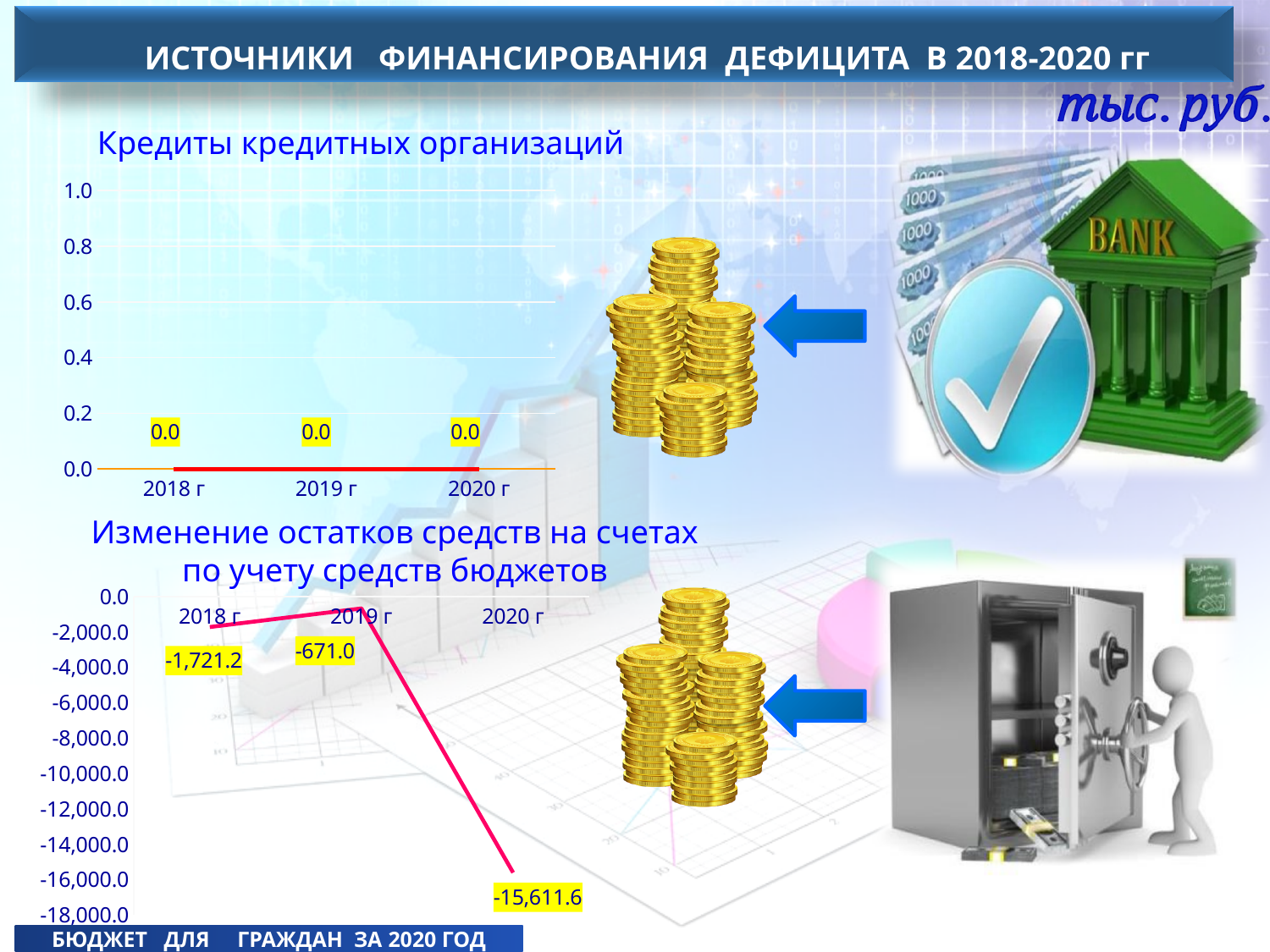
In the chart 'Изменение остатков средств на счетах по учету средств бюджетов', what is the difference between the values for 2019 г and 2020 г? 14,940.6 In the chart 'Изменение остатков средств на счетах по учету средств бюджетов', what is the value for 2020 г? -15,611.6 In the chart 'Изменение остатков средств на счетах по учету средств бюджетов', what is the value for 2019 г? -671.0 In the chart 'Кредиты кредитных организаций', what is the value for 2019 г? 0.0 What unit of measurement is stated on the slide for the charts? тыс. руб. In the chart 'Изменение остатков средств на счетах по учету средств бюджетов', which is larger, the value for 2018 г or the value for 2019 г? 2019 г In the chart 'Изменение остатков средств на счетах по учету средств бюджетов', is the value for 2020 г greater or less than -14,000.0? less What kind of chart is 'Кредиты кредитных организаций'? line chart In the chart 'Кредиты кредитных организаций', how many years are plotted? 3 In the chart 'Изменение остатков средств на счетах по учету средств бюджетов', which year has the lowest value? 2020 г In the chart 'Изменение остатков средств на счетах по учету средств бюджетов', which year has the highest value? 2019 г In the chart 'Изменение остатков средств на счетах по учету средств бюджетов', what is the value for 2018 г? -1,721.2